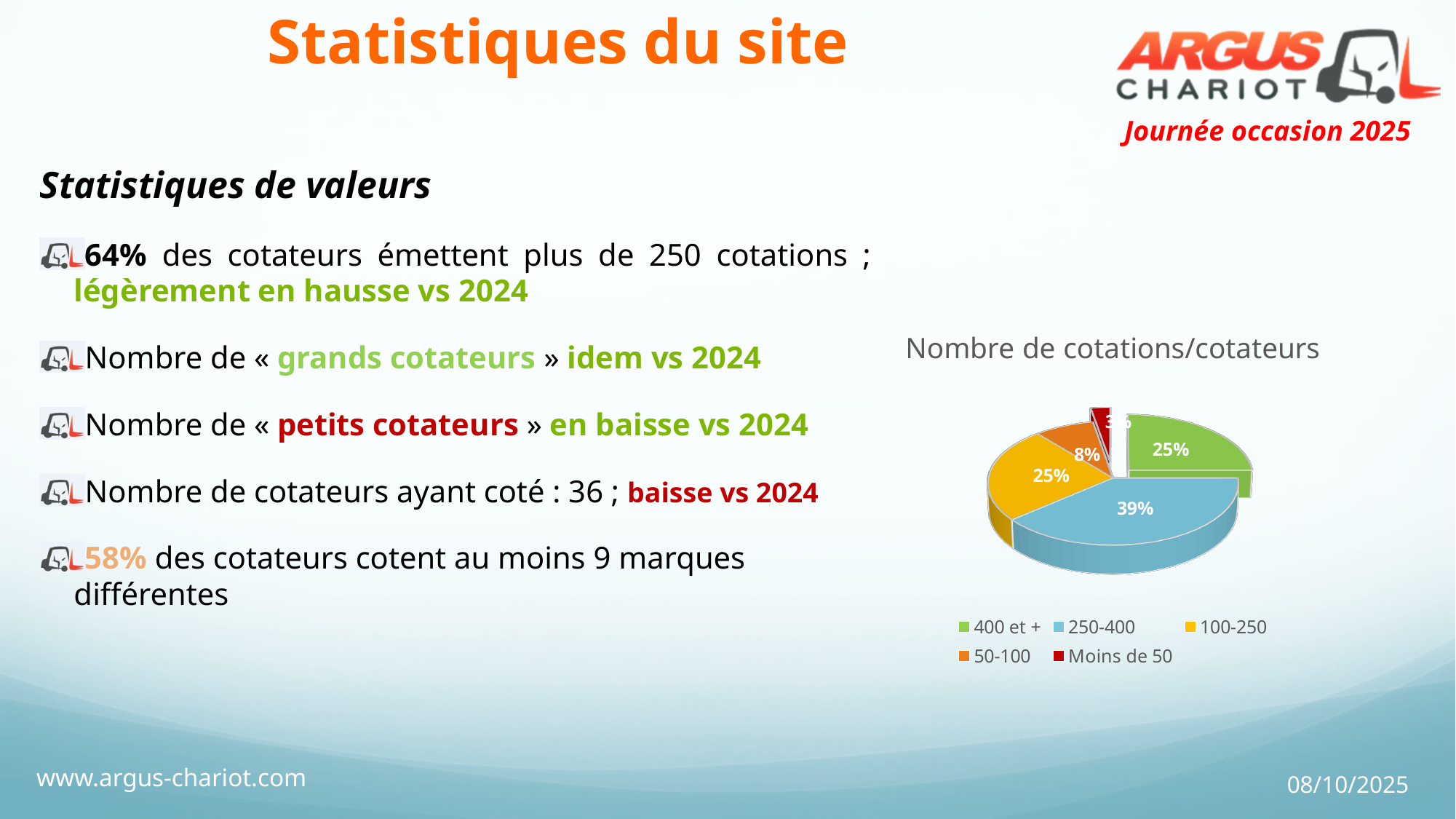
Which category has the smallest slice of the pie? Moins de 50 What is the value shown for the 400 et + slice? 25% What is the title of the pie chart? Nombre de cotations/cotateurs What is the difference in percentage points between the 250-400 slice and the 50-100 slice? 31 What is the value shown for the 100-250 slice? 25% Which is larger, the 250-400 slice or the 50-100 slice? 250-400 Which category has the largest slice of the pie? 250-400 How many slices does the pie chart have? 5 What is the value shown for the 50-100 slice? 8% What kind of chart is shown on the slide? pie chart What share of the pie does the 250-400 category represent? 39% What colour is the 250-400 slice in the pie chart? blue